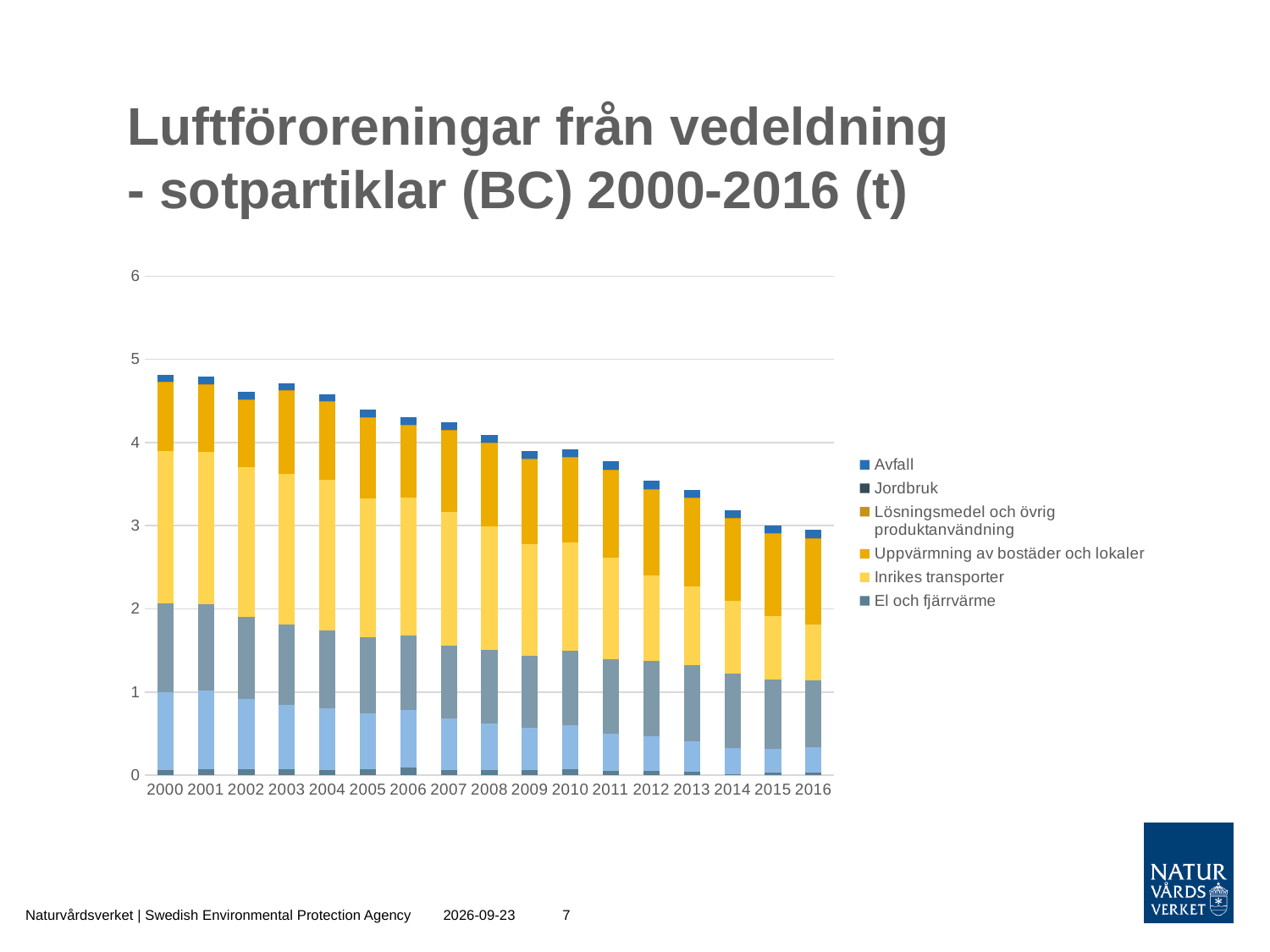
Is the total value for 2014 greater or less than 3? greater Is the total value for 2016 greater or less than 4? less How many series does the chart's legend list? 6 Do the total bar heights rise or fall from 2000 to 2016? fall What is the title of the slide containing the chart? Luftföroreningar från vedeldning - sotpartiklar (BC) 2000-2016 (t) Is the total value for 2000 greater or less than 4? greater How many years are shown along the x axis of the chart? 17 Which series is listed first in the chart's legend? Avfall What kind of chart is shown on the slide? stacked bar chart